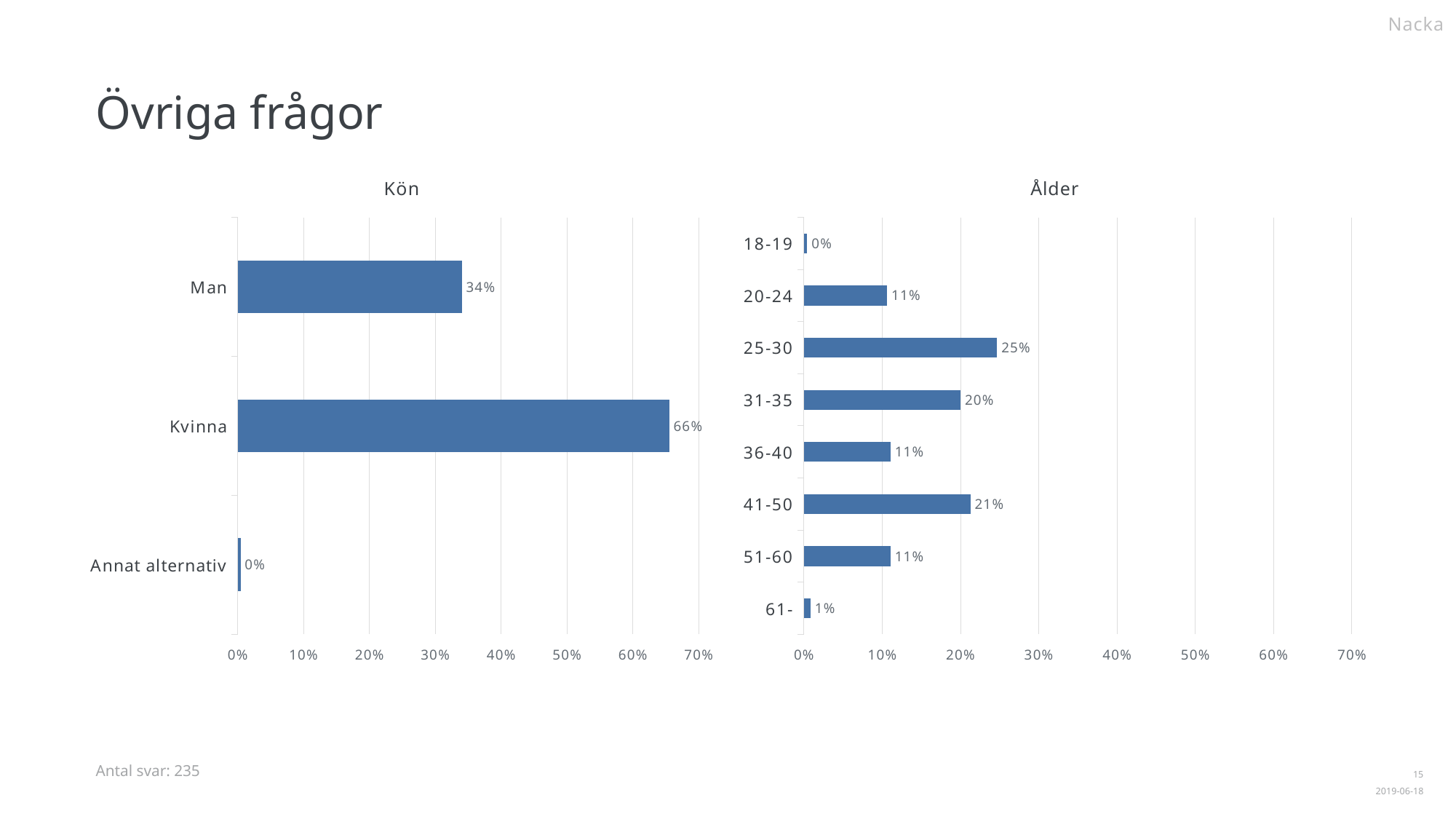
In the Ålder chart, what is the value for 25-30? 25% In the Kön chart, what is the difference between the values for Kvinna and Man? 32% In the Ålder chart, which is larger, the value for 31-35 or the value for 36-40? 31-35 In the Kön chart, what is the value for Man? 34% In the Ålder chart, what is the difference between the values for 25-30 and 20-24? 14% In the Ålder chart, which age group has the highest value? 25-30 In the Kön chart, what is the value for Kvinna? 66% In the Ålder chart, what is the value for 41-50? 21% In the Kön chart, how many categories are shown? 3 In the Kön chart, which category has the highest value? Kvinna What kind of chart is the Ålder chart? Bar chart In the Ålder chart, how many age groups are shown? 8